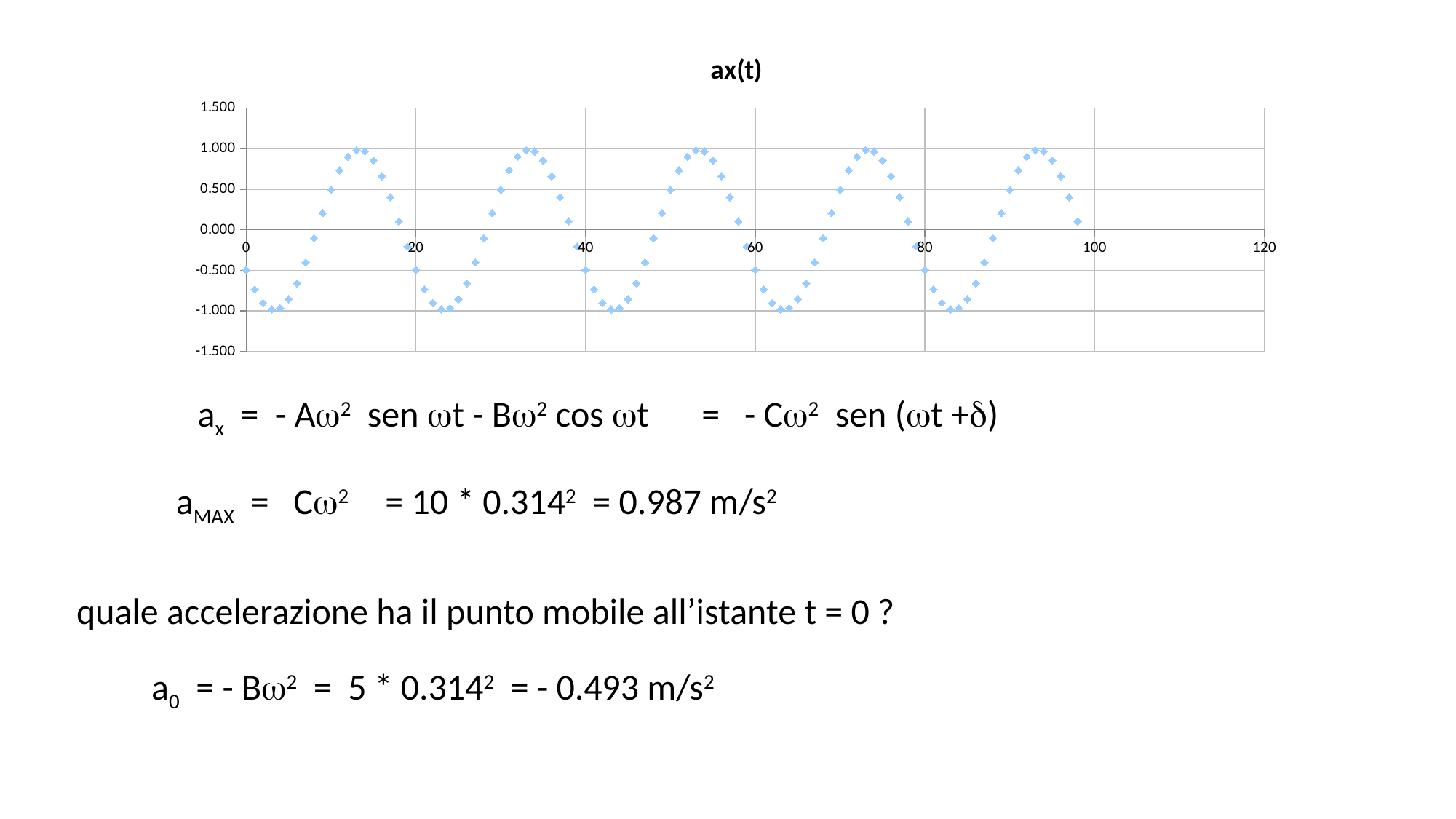
Is the plotted value near t = 13 greater or less than 0.500? greater What is the largest value labelled on the horizontal axis? 120 Do the plotted values rise steadily, fall steadily, or oscillate along the x axis? oscillate What is the highest value labelled on the vertical axis of the chart? 1.500 Is the plotted value near t = 60 greater or less than 0.000? less Is the plotted value near t = 23 greater or less than -0.500? less How many peaks (maxima) does the plotted curve show? 5 What kind of chart is shown on the slide? scatter chart What is the title of the chart? ax(t)